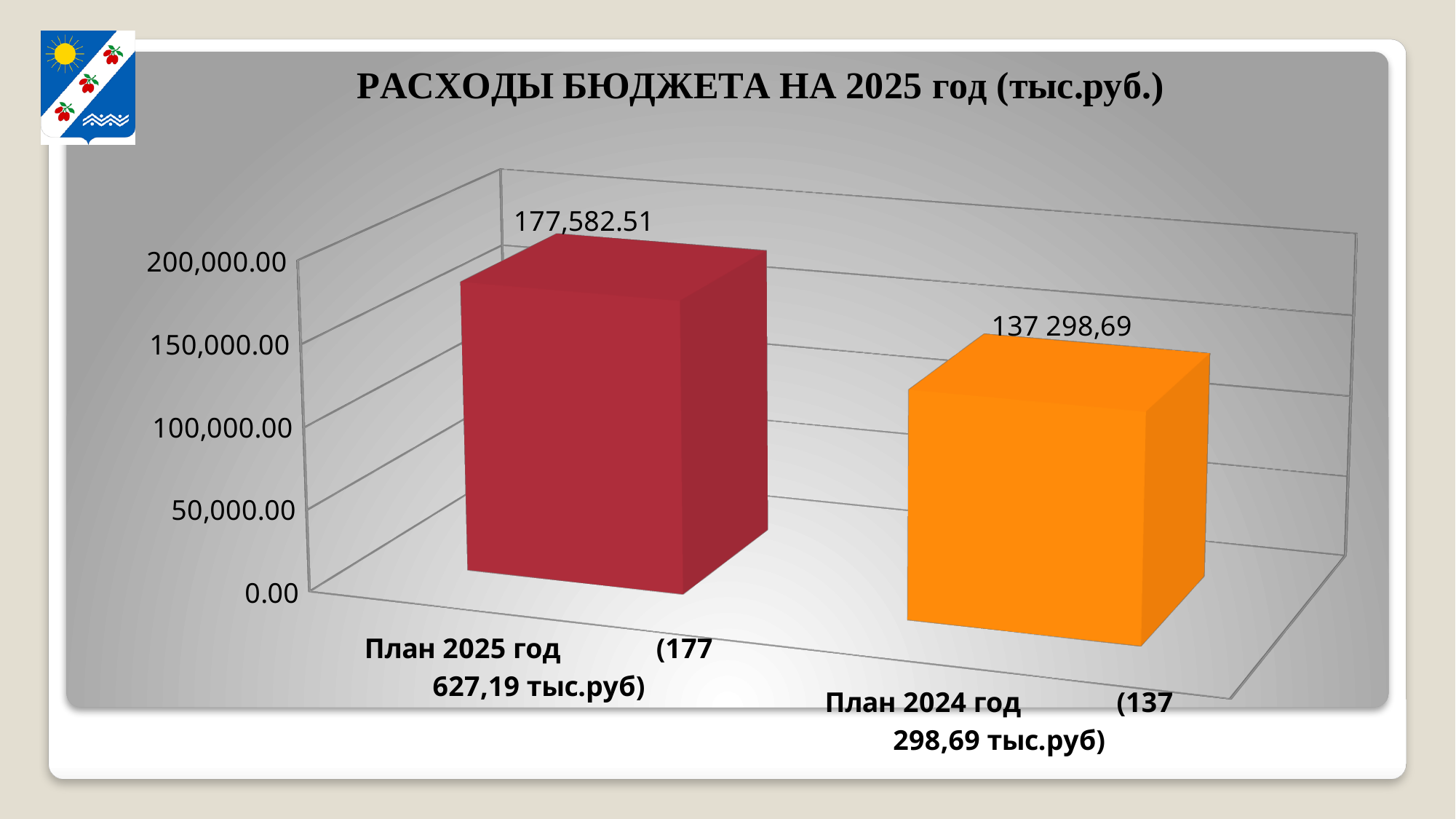
How many bars are plotted in the chart? 2 What value is labelled on the bar for План 2025 год? 177,582.51 Do the bar values rise or fall from left to right along the x axis? fall Which category has the lowest bar? План 2024 год Is the value for План 2024 год greater or less than 150,000.00? less What kind of chart is shown on the slide? bar chart What value is labelled on the bar for План 2024 год? 137 298,69 Is the value for План 2025 год greater or less than 150,000.00? greater What colour is the bar for План 2024 год? orange Which is larger, the bar for План 2025 год or the bar for План 2024 год? План 2025 год What is the title of the chart? РАСХОДЫ БЮДЖЕТА НА 2025 год (тыс.руб.) Which category has the highest bar? План 2025 год